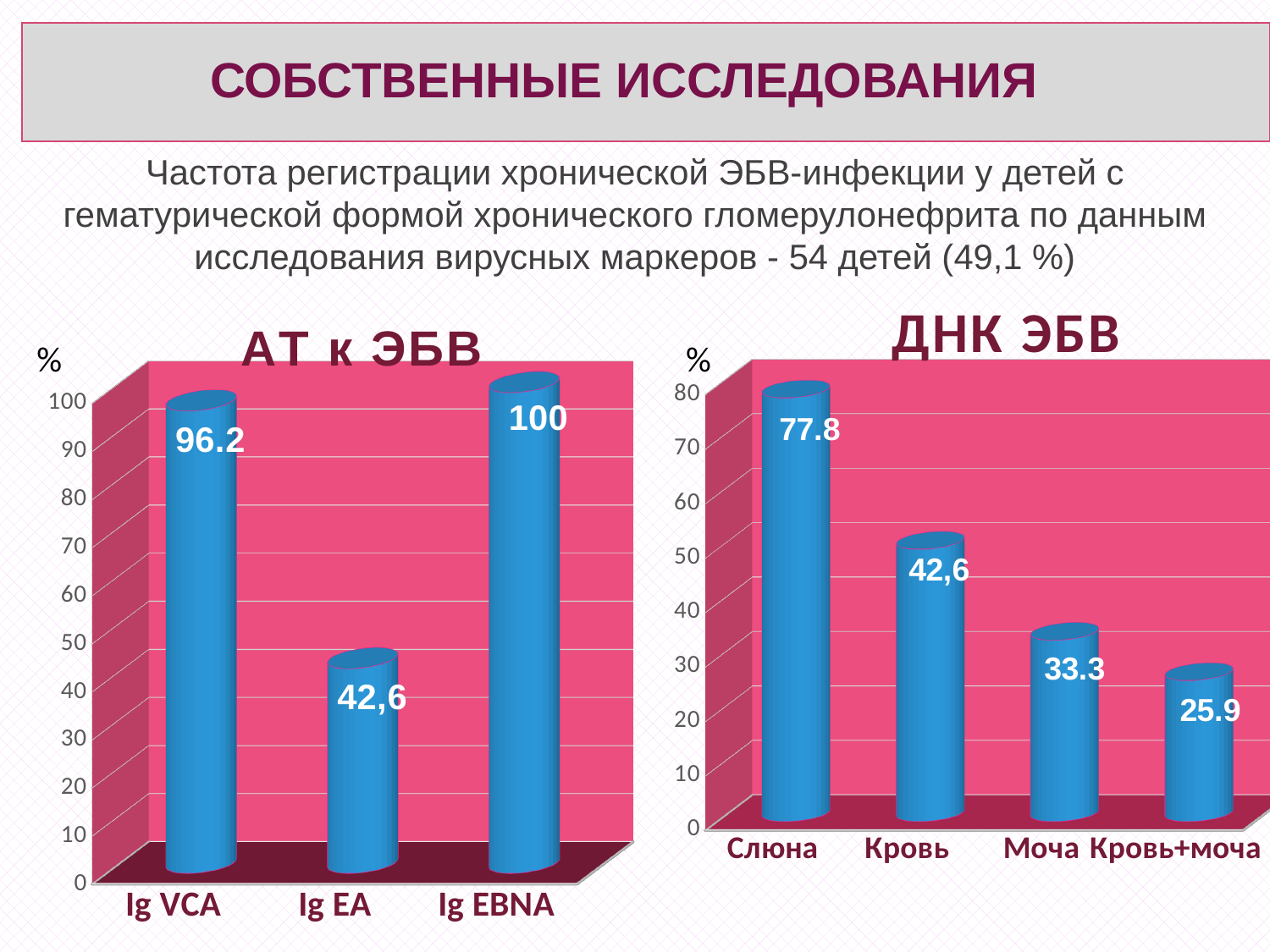
In the chart titled "ДНК ЭБВ", what is the difference between the values for Моча and Кровь+моча? 7.4 In the chart titled "АТ к ЭБВ", what is the value for Ig EA? 42,6 In the chart titled "ДНК ЭБВ", which is larger, the value for Кровь or the value for Моча? Кровь In the chart titled "АТ к ЭБВ", what is the value for Ig VCA? 96.2 In the chart titled "ДНК ЭБВ", which category has the lowest value? Кровь+моча In the chart titled "АТ к ЭБВ", how many categories are shown? 3 In the chart titled "ДНК ЭБВ", do the values rise or fall from left to right along the x axis? fall In the chart titled "ДНК ЭБВ", what is the value for Кровь+моча? 25.9 What kind of chart is the chart titled "ДНК ЭБВ"? bar chart In the chart titled "АТ к ЭБВ", which category has the highest value? Ig EBNA In the chart titled "ДНК ЭБВ", what is the value for Слюна? 77.8 In the chart titled "АТ к ЭБВ", what is the difference between the values for Ig EBNA and Ig VCA? 3.8